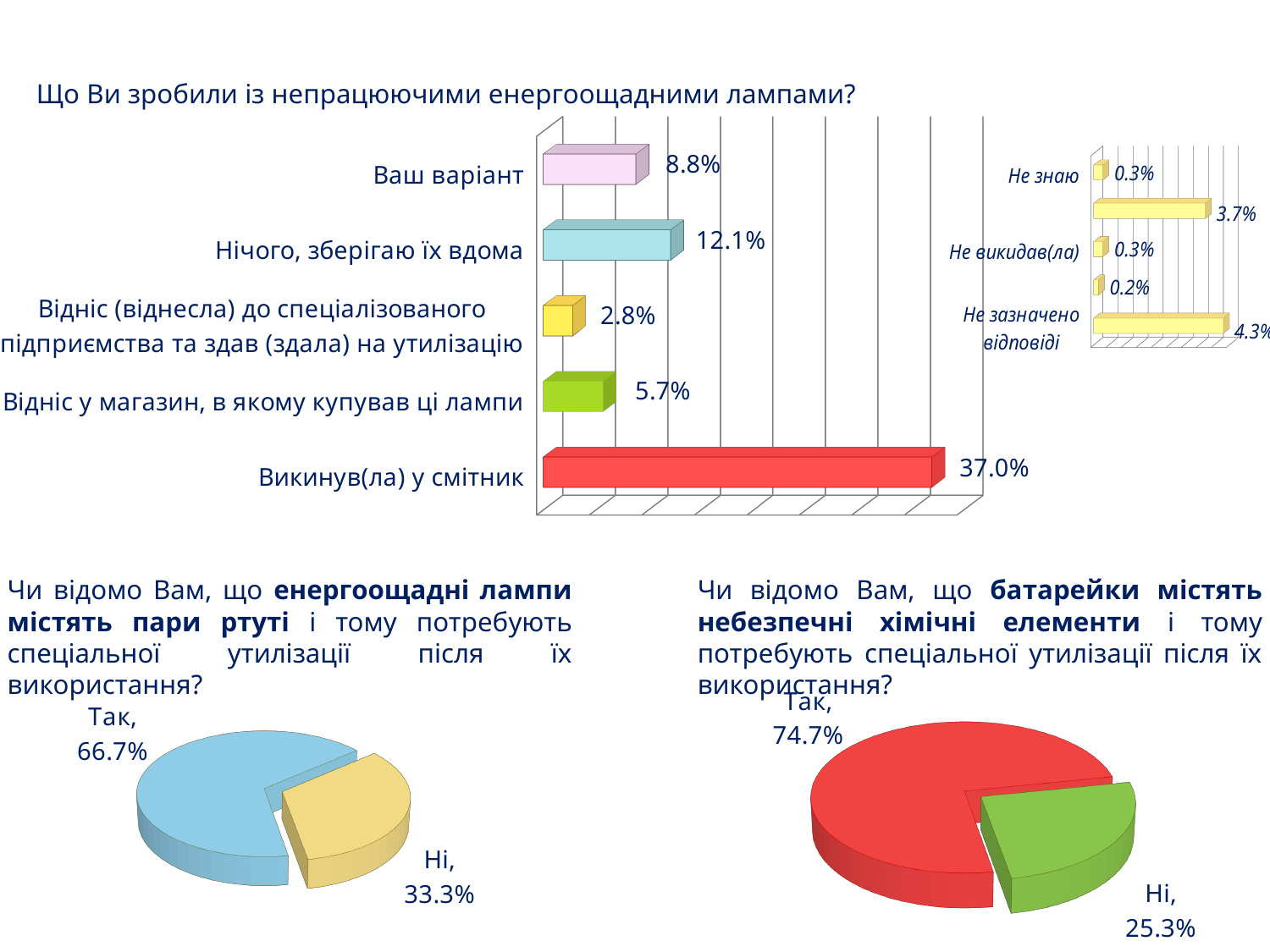
In the bar chart titled 'Що Ви зробили із непрацюючими енергоощадними лампами?', what is the value for 'Ваш варіант'? 8.8% In the bar chart titled 'Що Ви зробили із непрацюючими енергоощадними лампами?', which is larger: 'Відніс у магазин, в якому купував ці лампи' or 'Ваш варіант'? Ваш варіант What type of chart is used for 'Що Ви зробили із непрацюючими енергоощадними лампами?'? Bar chart In the bar chart titled 'Що Ви зробили із непрацюючими енергоощадними лампами?', what is the value for 'Нічого, зберігаю їх вдома'? 12.1% In the bar chart titled 'Що Ви зробили із непрацюючими енергоощадними лампами?', which category has the lowest value? Відніс (віднесла) до спеціалізованого підприємства та здав (здала) на утилізацію In the pie chart on the bottom right (about batteries containing hazardous chemical elements), what share answered 'Ні'? 25.3% In the bar chart titled 'Що Ви зробили із непрацюючими енергоощадними лампами?', what is the value for 'Викинув(ла) у смітник'? 37.0% In the pie chart on the bottom left (about energy-saving lamps containing mercury vapour), what share answered 'Так'? 66.7% In the small bar chart at the top right, what is the value for 'Не зазначено відповіді'? 4.3% In the bar chart titled 'Що Ви зробили із непрацюючими енергоощадними лампами?', which category has the highest value? Викинув(ла) у смітник How many categories are shown in the main bar chart titled 'Що Ви зробили із непрацюючими енергоощадними лампами?'? 5 In the bar chart titled 'Що Ви зробили із непрацюючими енергоощадними лампами?', what is the difference between 'Викинув(ла) у смітник' and 'Нічого, зберігаю їх вдома'? 24.9%